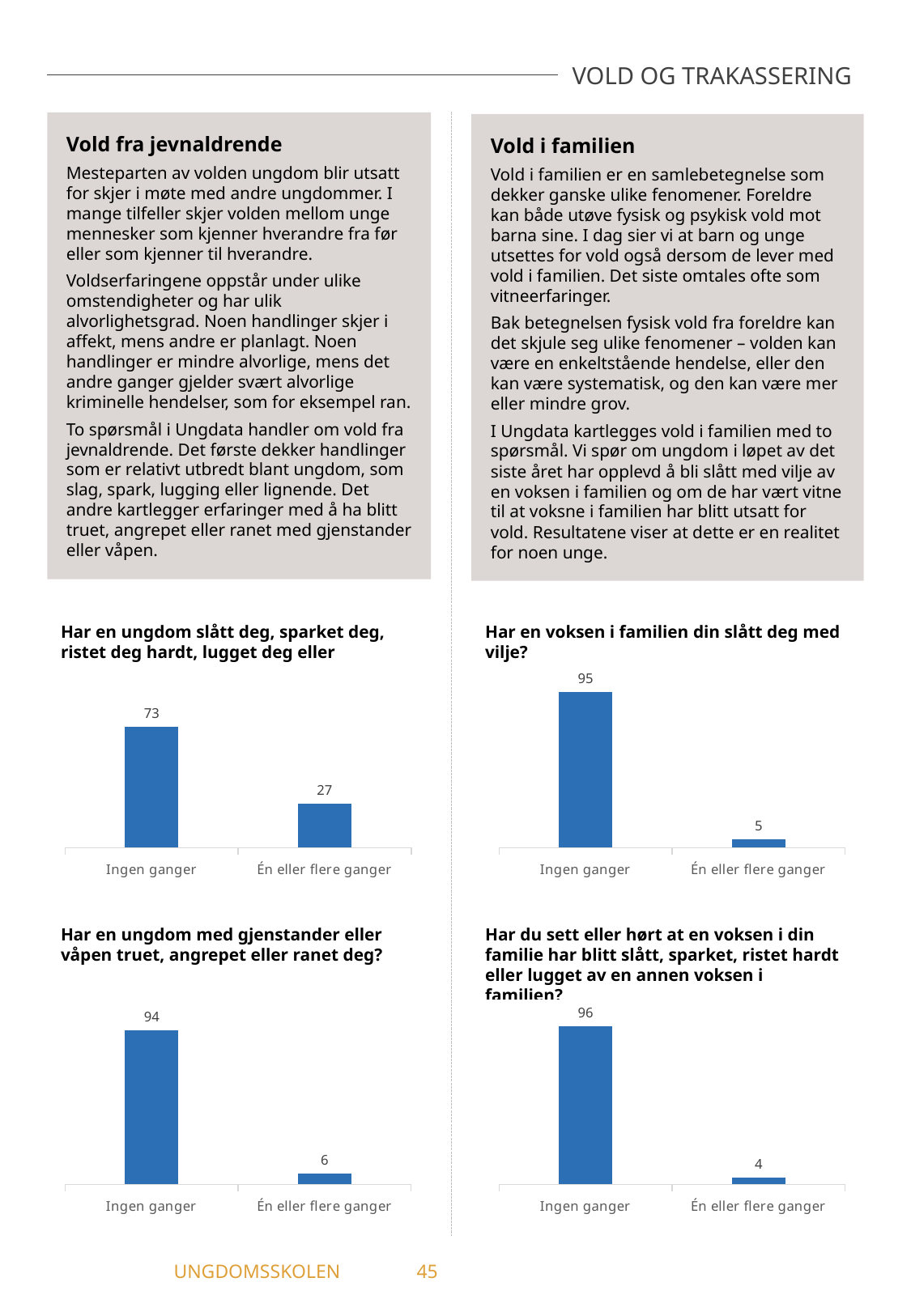
What type of chart is the top-left chart ("Har en ungdom slått deg, sparket deg...")? Bar chart In the bottom-right chart ("Har du sett eller hørt at en voksen i din familie..."), what is the value for "Ingen ganger"? 96 In the bottom-right chart ("Har du sett eller hørt at en voksen i din familie..."), what is the total of the two bars? 100 In the top-left chart ("Har en ungdom slått deg, sparket deg..."), what is the value for "Én eller flere ganger"? 27 In the top-right chart ("Har en voksen i familien din slått deg med vilje?"), what is the value for "Én eller flere ganger"? 5 In the top-left chart ("Har en ungdom slått deg, sparket deg..."), what is the difference between the two bars? 46 In the bottom-right chart ("Har du sett eller hørt at en voksen i din familie..."), which category has the lowest value? Én eller flere ganger How many categories are shown in the top-right chart ("Har en voksen i familien din slått deg med vilje?")? 2 In the top-right chart ("Har en voksen i familien din slått deg med vilje?"), what is the value for "Ingen ganger"? 95 In the bottom-left chart ("Har en ungdom med gjenstander eller våpen truet, angrepet eller ranet deg?"), what is the value for "Én eller flere ganger"? 6 In the top-left chart ("Har en ungdom slått deg, sparket deg..."), what is the value for "Ingen ganger"? 73 In the bottom-left chart ("Har en ungdom med gjenstander eller våpen truet, angrepet eller ranet deg?"), which category has the highest value? Ingen ganger